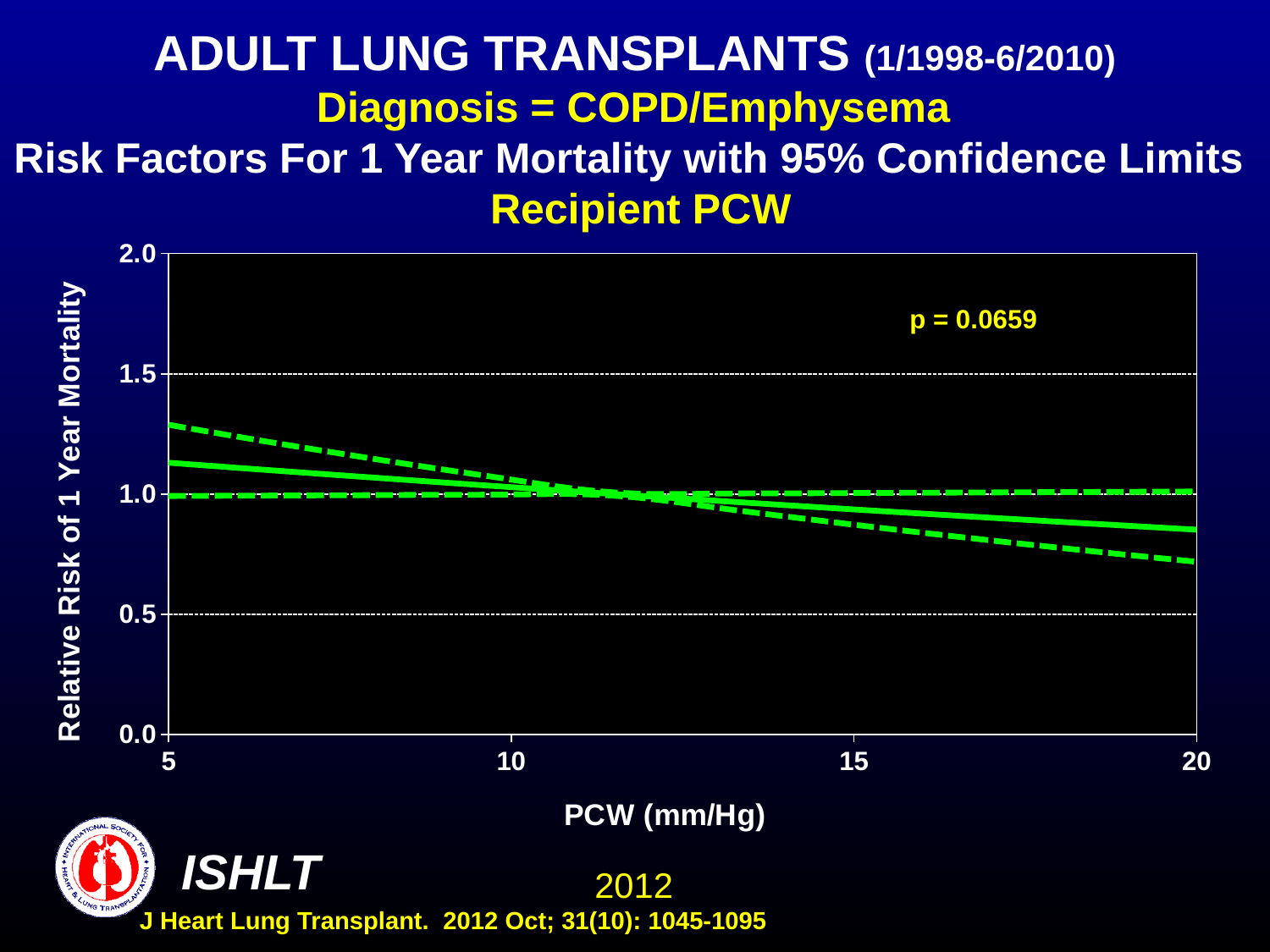
How many lines are plotted on the chart? 3 What p-value is shown on the chart? p = 0.0659 What kind of chart is shown on the slide? line chart Does the solid relative risk line rise or fall as PCW increases from 5 to 20 mm/Hg? fall Is the lower 95% confidence limit (lower dashed line) at a PCW of 20 mm/Hg greater or less than 0.5? greater Is the relative risk (solid line) at a PCW of 5 mm/Hg greater or less than 1.0? greater Is the relative risk at a PCW of 5 mm/Hg larger or smaller than the relative risk at a PCW of 20 mm/Hg? larger Is the upper 95% confidence limit (upper dashed line) at a PCW of 5 mm/Hg greater or less than 1.0? greater What is the label of the x axis? PCW (mm/Hg)